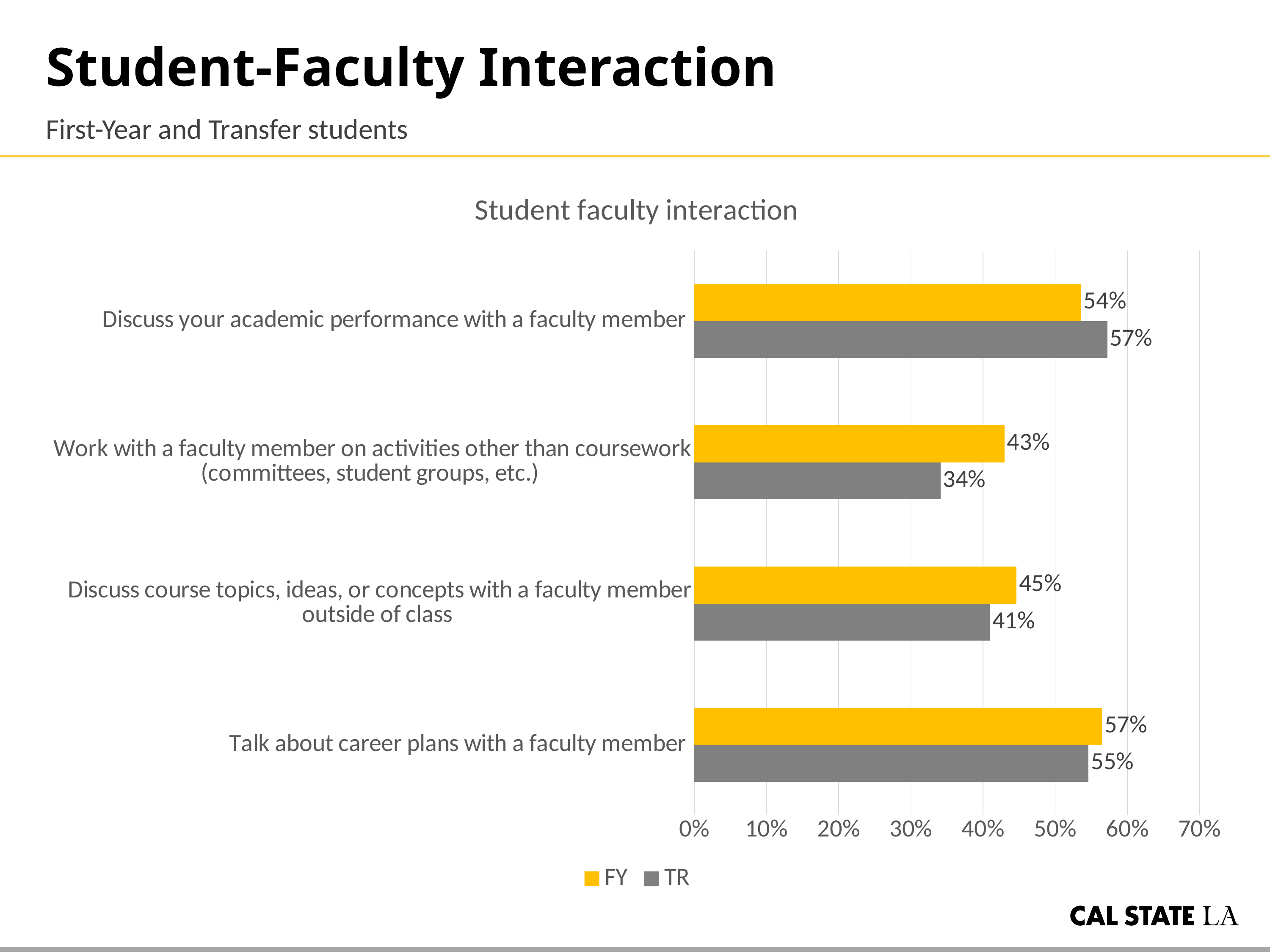
What is the difference between the FY and TR values for "Work with a faculty member on activities other than coursework (committees, student groups, etc.)"? 9% For "Discuss your academic performance with a faculty member", which is larger, the FY value or the TR value? TR For "Discuss course topics, ideas, or concepts with a faculty member outside of class", which is larger, the FY value or the TR value? FY What is the title of the chart? Student faculty interaction What is the TR value for "Work with a faculty member on activities other than coursework (committees, student groups, etc.)"? 34% What kind of chart is shown on the slide? Bar chart How many series does the legend list? 2 Which category has the highest FY value? Talk about career plans with a faculty member Which category has the lowest TR value? Work with a faculty member on activities other than coursework (committees, student groups, etc.) How many categories are shown on the chart? 4 What is the TR value for "Talk about career plans with a faculty member"? 55% What is the FY value for "Discuss your academic performance with a faculty member"? 54%